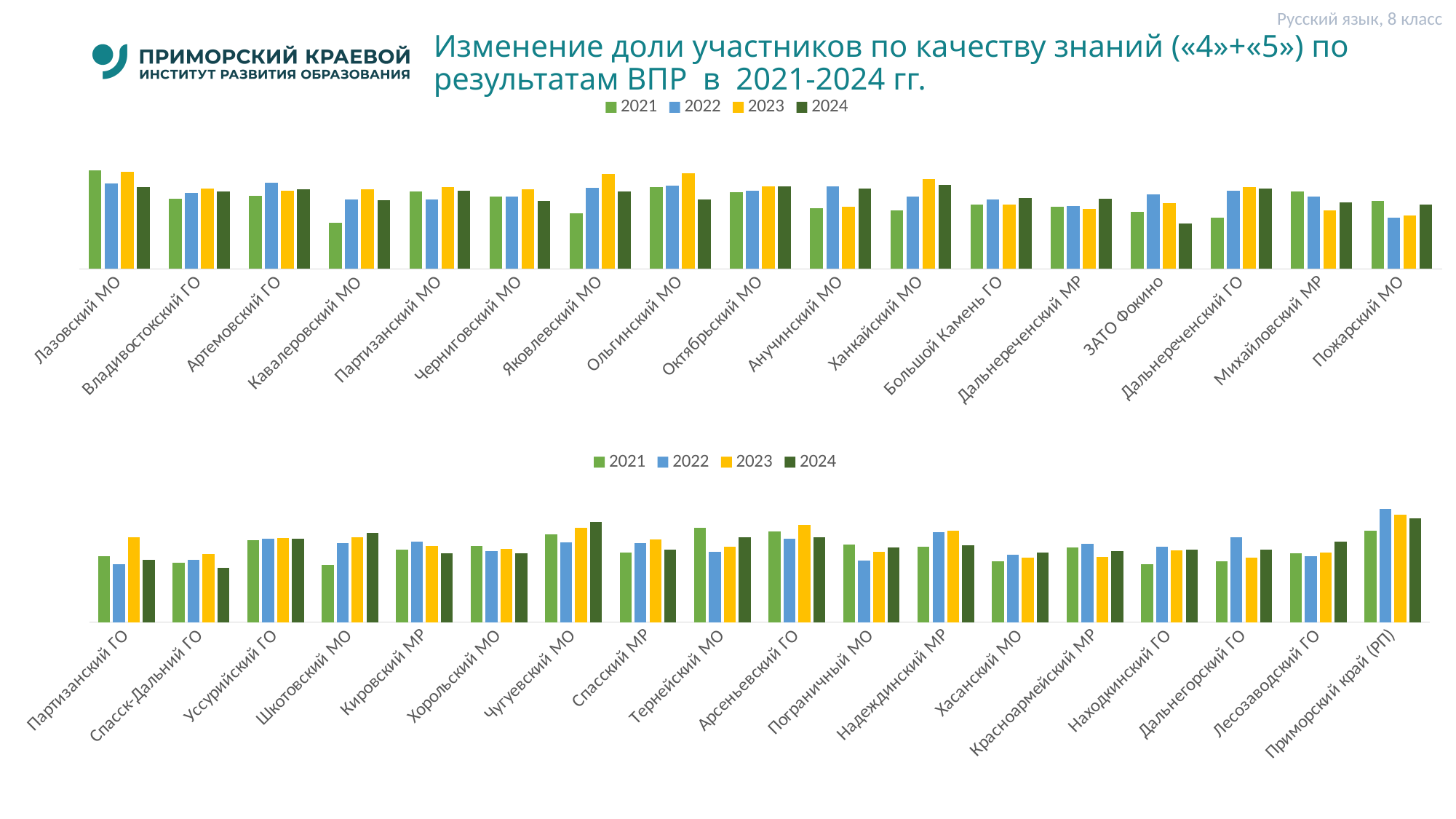
In the bottom chart, which year has the highest value for Чугуевский МО? 2024 How many categories are shown on the x axis of the top chart? 17 In the bottom chart, which year has the highest value for Приморский край (РП)? 2022 What kind of chart is the top chart on the slide? bar chart In the top chart, for Яковлевский МО, which is larger: the 2021 value or the 2023 value? 2023 Which year is shown in yellow in the legend of the charts? 2023 In the top chart, for Кавалеровский МО, which is larger: the 2021 value or the 2023 value? 2023 How many series does the legend of the top chart list? 4 In the bottom chart, which year has the lowest value for Спасск-Дальний ГО? 2024 How many categories are shown on the x axis of the bottom chart? 18 In the bottom chart, which year has the highest value for Партизанский ГО? 2023 In the top chart, for ЗАТО Фокино, which is larger: the 2022 value or the 2024 value? 2022